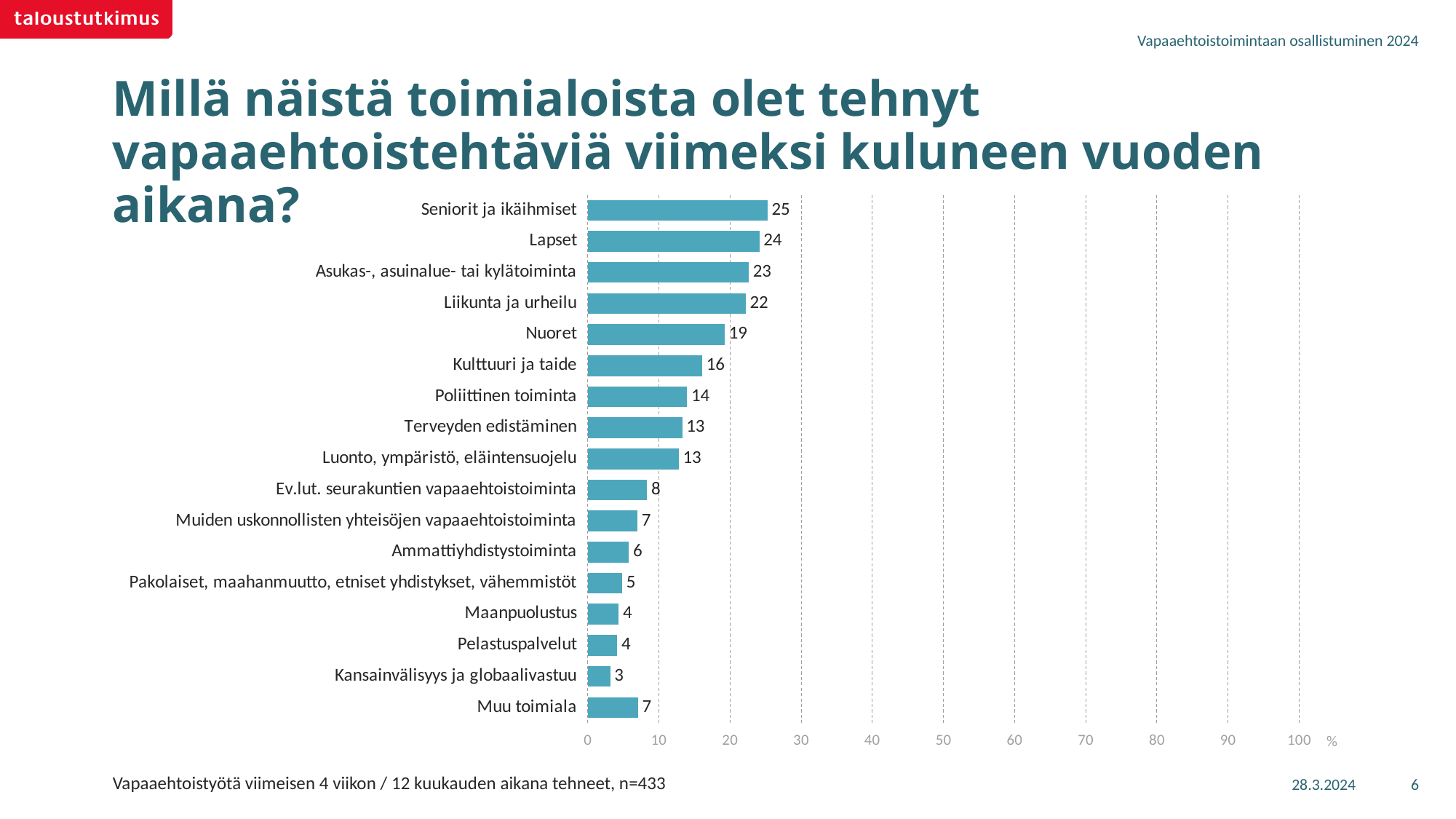
What is the value for Muu toimiala? 7 What is the difference between the values for Lapset and Kulttuuri ja taide? 8 What is the value for Seniorit ja ikäihmiset? 25 Which is larger, the value for Liikunta ja urheilu or the value for Poliittinen toiminta? Liikunta ja urheilu What unit is shown at the end of the horizontal axis? % Which category has the lowest value? Kansainvälisyys ja globaalivastuu What is the value for Ev.lut. seurakuntien vapaaehtoistoiminta? 8 Which category has the highest value? Seniorit ja ikäihmiset How many categories are shown in the chart? 17 Is the value for Asukas-, asuinalue- tai kylätoiminta greater or less than 20? greater What is the value for Nuoret? 19 What kind of chart is shown on the slide? bar chart